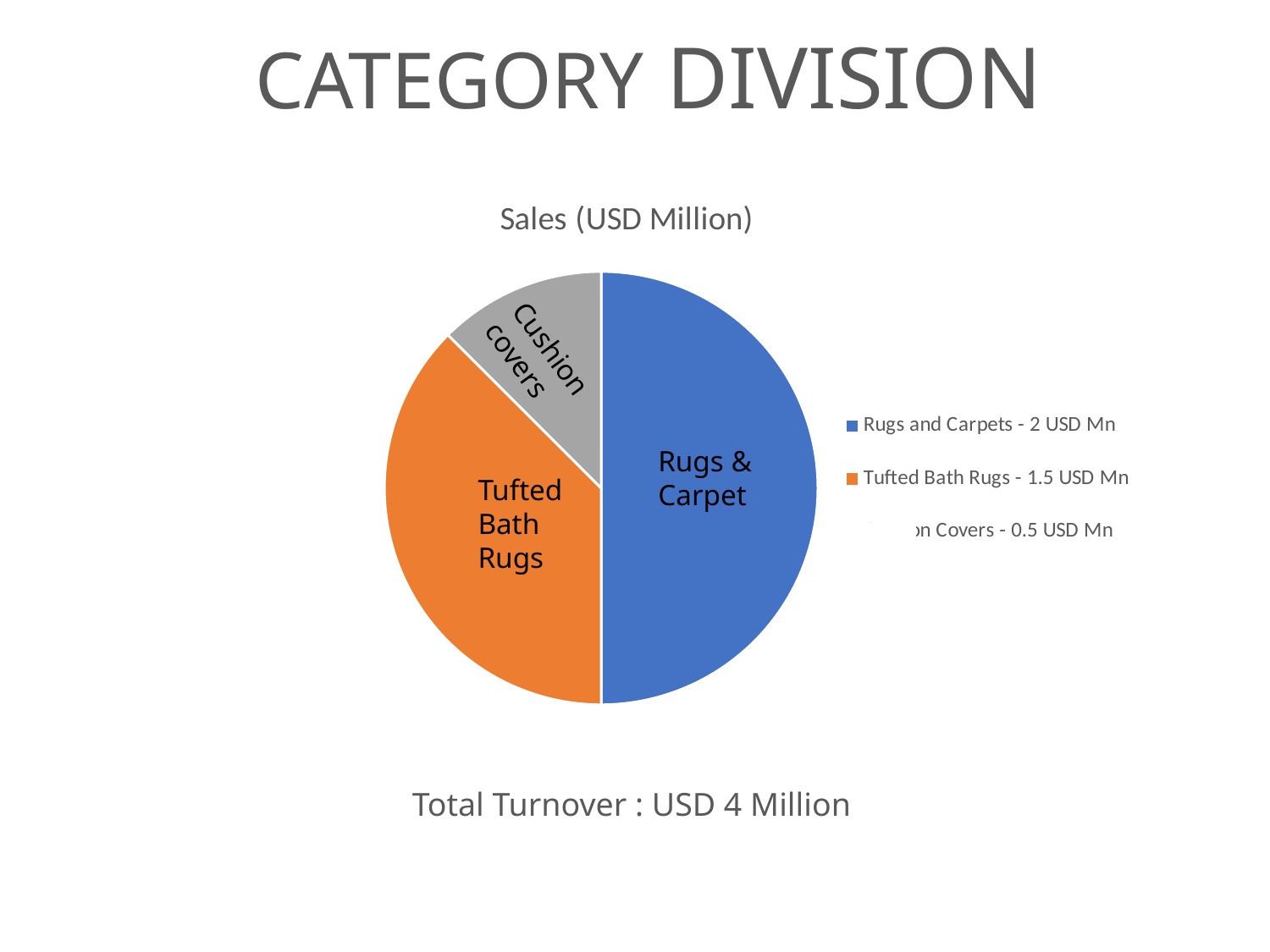
What colour is the Tufted Bath Rugs slice? Orange What type of chart is shown on the slide? Pie chart Which category has the smallest slice of the pie? Cushion covers What share of total sales does the Rugs & Carpet slice represent? 50% What is the sales value for Rugs and Carpets according to the legend? 2 USD Mn What is the title of the chart? Sales (USD Million) Which is larger, the sales for Tufted Bath Rugs or for Cushion Covers? Tufted Bath Rugs What is the sales value for Cushion Covers according to the legend? 0.5 USD Mn Which category has the largest slice of the pie? Rugs & Carpet What is the difference in sales between Rugs and Carpets and Tufted Bath Rugs? 0.5 USD Mn How many slices does the pie chart have? 3 What is the sales value for Tufted Bath Rugs according to the legend? 1.5 USD Mn